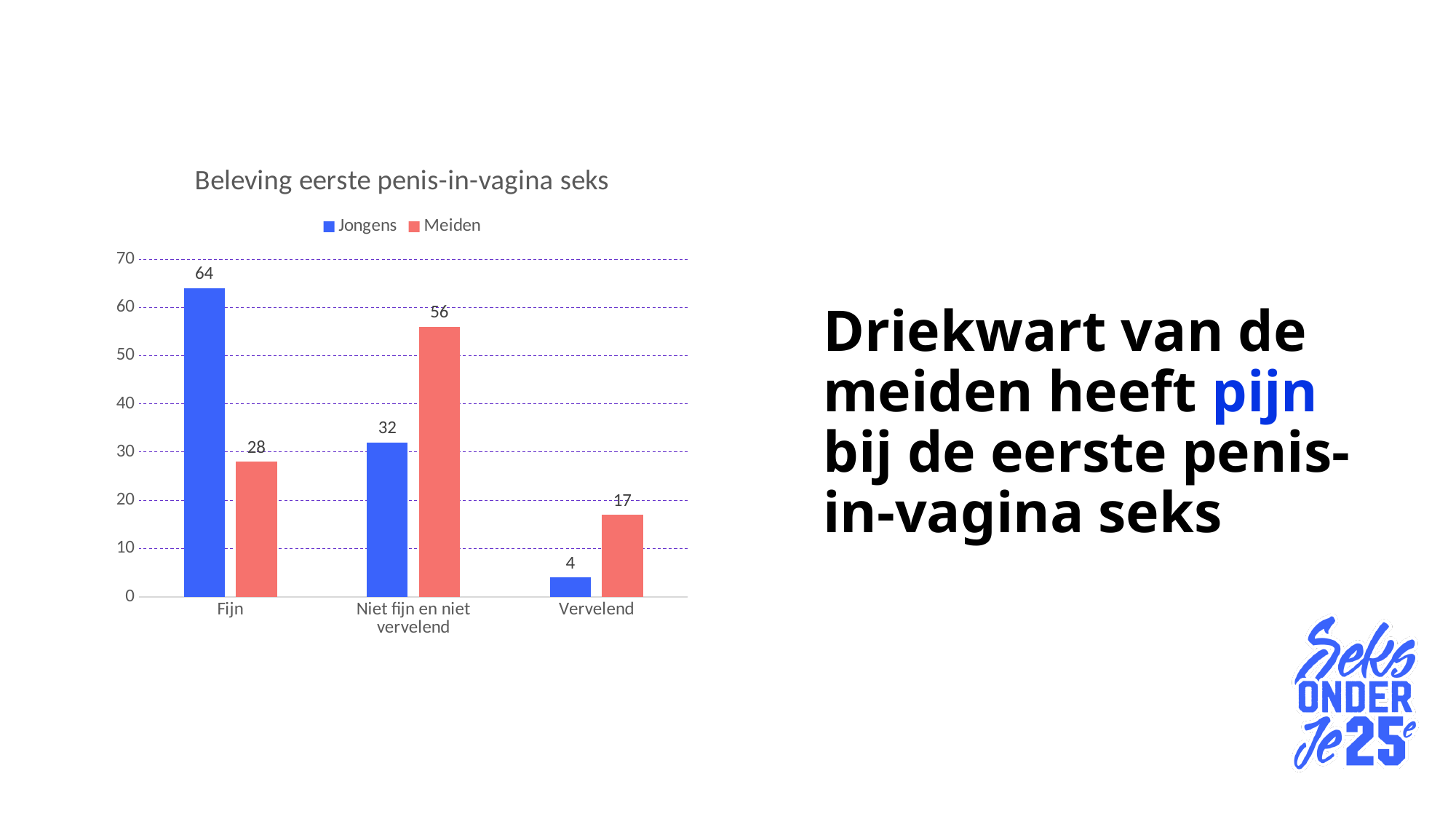
Do the values for Jongens rise or fall from Fijn to Vervelend? Fall How many series does the legend list? 2 Which category has the highest value for Jongens? Fijn How many categories are shown on the x axis? 3 Which is larger in the Vervelend category, Jongens or Meiden? Meiden What is the value for Meiden in the Vervelend category? 17 Which category has the lowest value for Meiden? Vervelend What kind of chart is shown on the slide? Bar chart What is the value for Jongens in the Fijn category? 64 What is the difference between Jongens and Meiden in the Fijn category? 36 What is the title of the chart? Beleving eerste penis-in-vagina seks What is the value for Meiden in the Niet fijn en niet vervelend category? 56